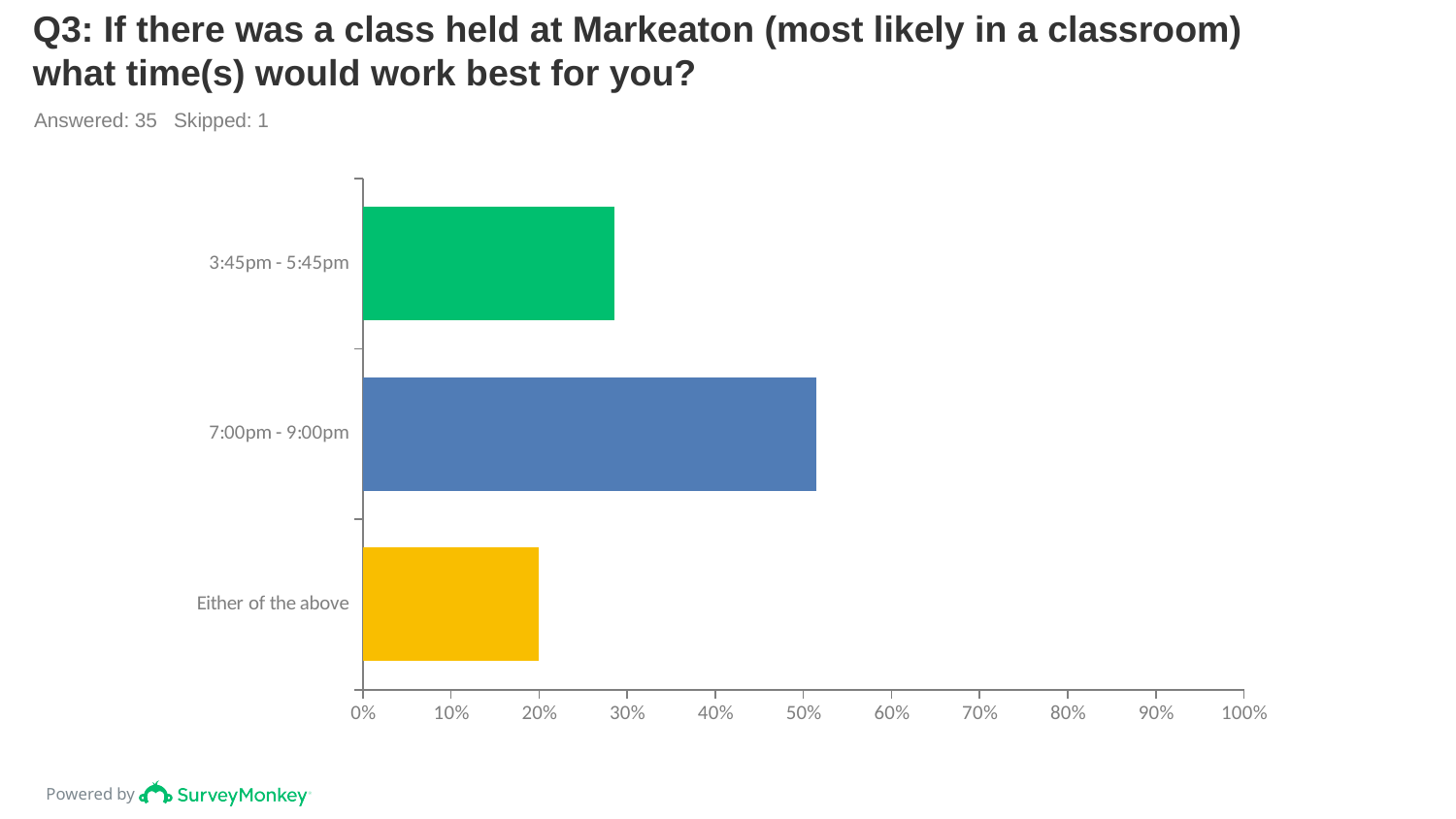
Is the value for 3:45pm - 5:45pm greater or less than 40%? less What kind of chart is shown on the slide? bar chart Is the value for 7:00pm - 9:00pm greater or less than 60%? less Which is larger, the value for 3:45pm - 5:45pm or the value for Either of the above? 3:45pm - 5:45pm What colour is the bar for 7:00pm - 9:00pm? blue Which category has the highest percentage? 7:00pm - 9:00pm What percentage is shown for Either of the above? 20% How many time-slot categories are plotted in the chart? 3 Is the value for 3:45pm - 5:45pm greater or less than 20%? greater How many respondents answered this question according to the slide? 35 Which category has the lowest percentage? Either of the above